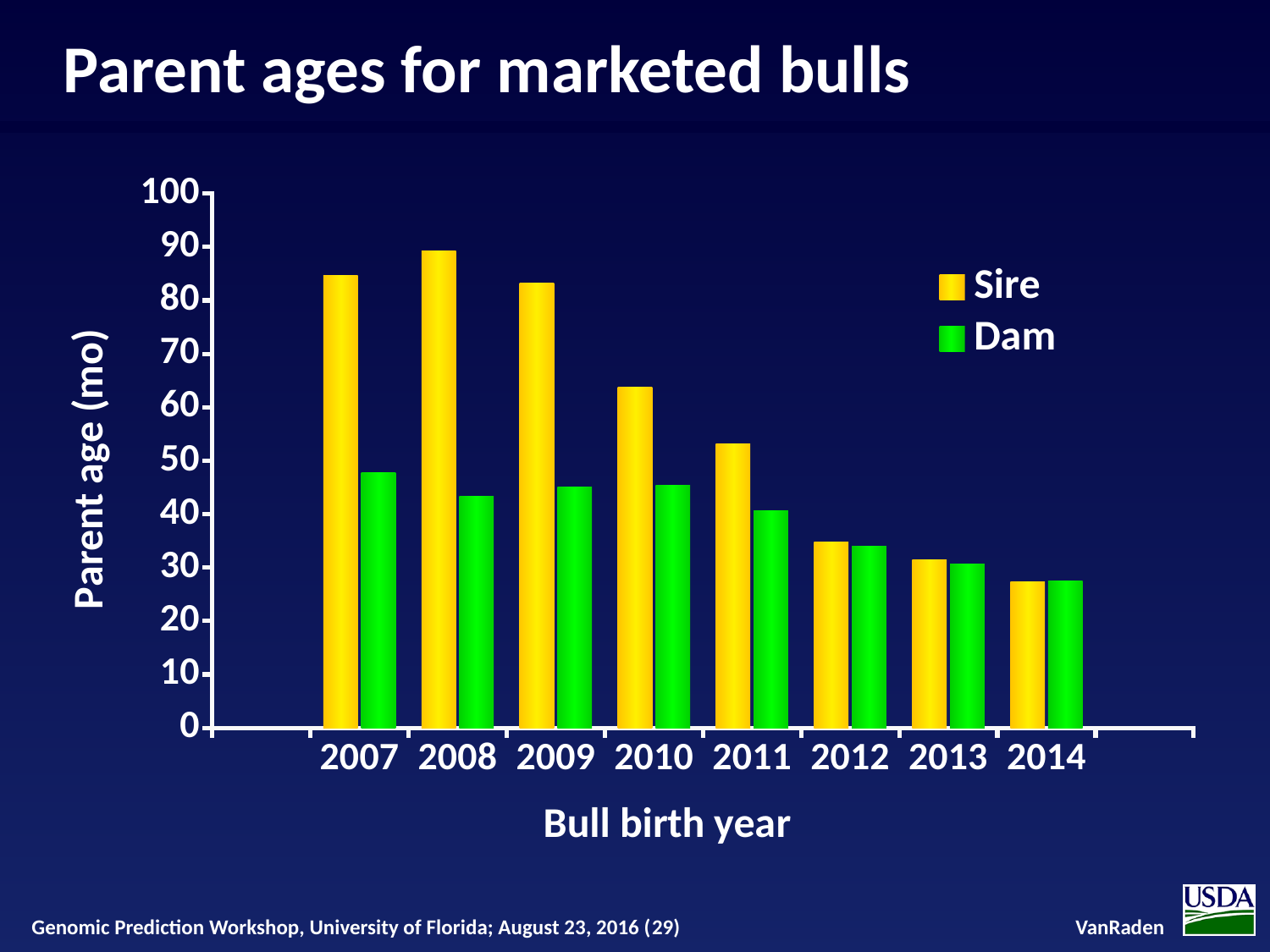
How many bull birth years are shown on the x axis? 8 How many series does the legend list? 2 What kind of chart is shown on the slide? bar chart What is the title of the y axis? Parent age (mo) For bull birth year 2007, which is larger, the Sire age or the Dam age? Sire In which bull birth year is the Dam parent age highest? 2007 Is the Dam parent age for 2007 greater or less than 50? less In which bull birth year is the Sire parent age lowest? 2014 Does the Sire parent age rise or fall from 2007 to 2014? fall Is the Sire parent age for 2012 greater or less than 40? less Is the Sire parent age for 2010 greater or less than 60? greater In which bull birth year is the Sire parent age highest? 2008